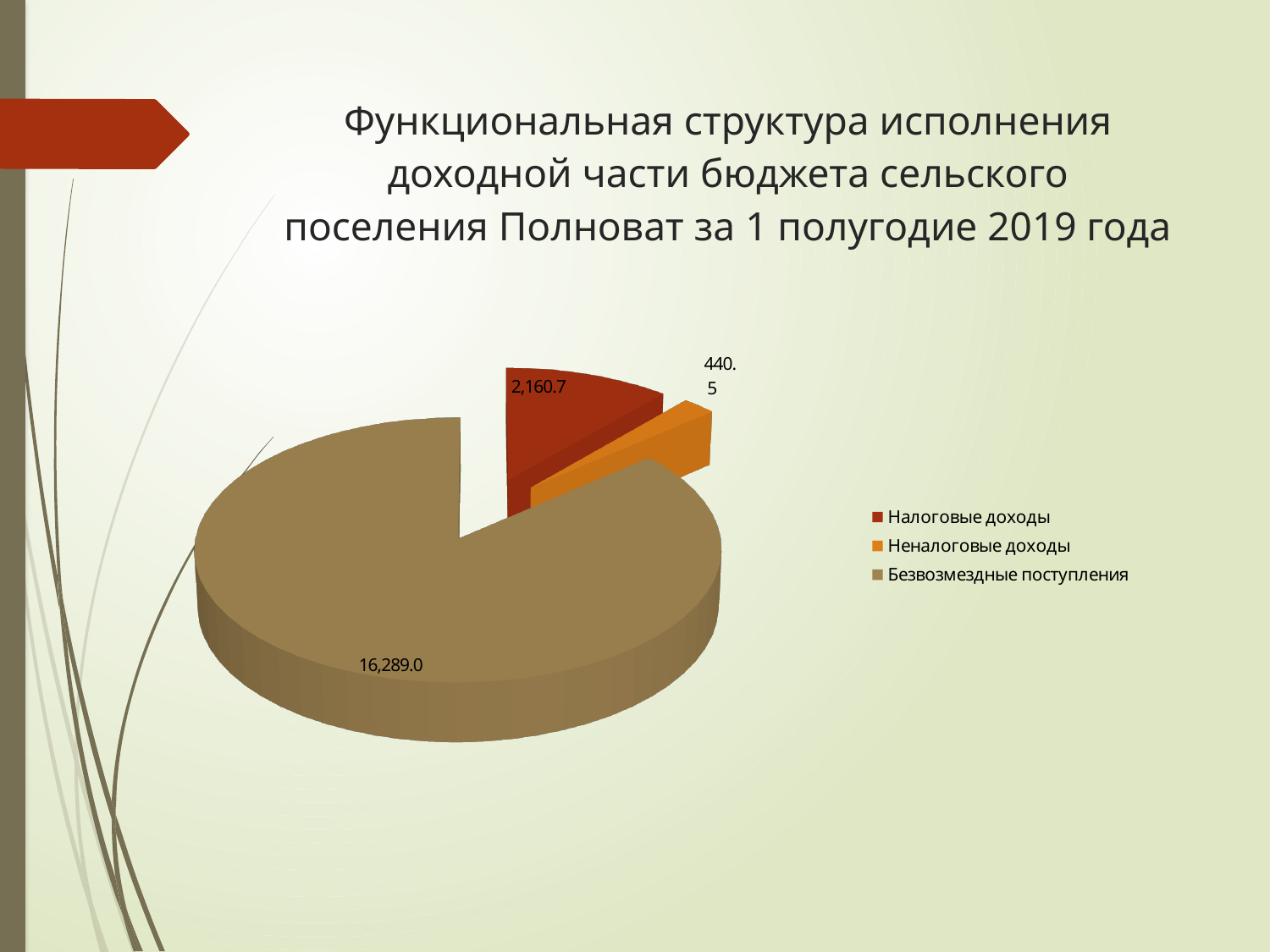
What is the difference between the values for Налоговые доходы and Неналоговые доходы? 1,720.2 What type of chart is shown on the slide? Pie chart What is the value for Налоговые доходы? 2,160.7 What is the difference between the values for Безвозмездные поступления and Налоговые доходы? 14,128.3 What is the value for Безвозмездные поступления? 16,289.0 What colour is the slice for Неналоговые доходы? Orange What is the total of all three slices of the pie? 18,890.2 Which category has the smallest slice of the pie? Неналоговые доходы Which is larger, Налоговые доходы or Неналоговые доходы? Налоговые доходы How many categories does the pie chart have? 3 Which category has the largest slice of the pie? Безвозмездные поступления What is the value for Неналоговые доходы? 440.5